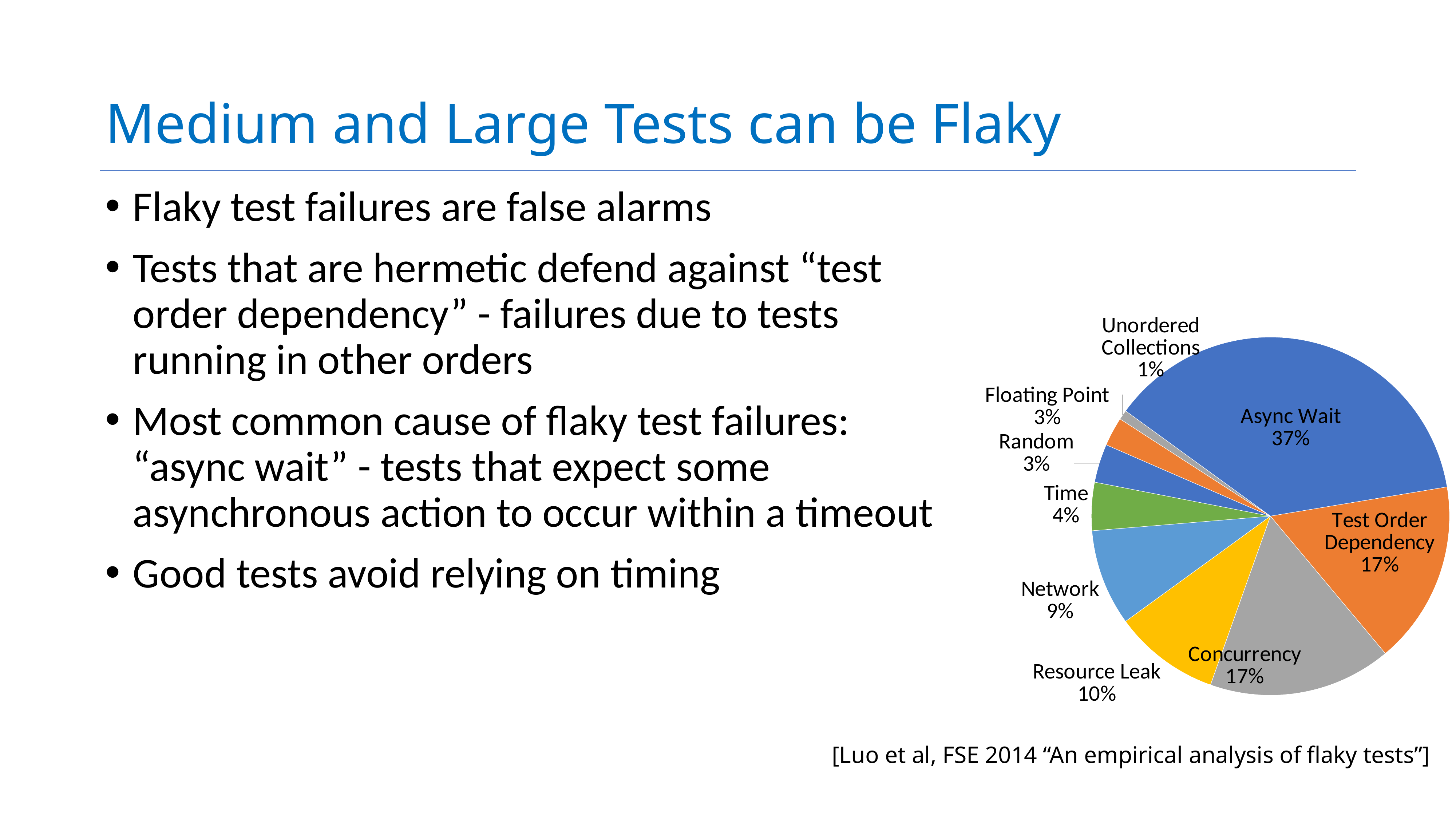
How many categories are shown in the pie chart? 9 What share of the pie does Resource Leak have? 10% What share of the pie does Async Wait have? 37% What is the difference in percentage points between Async Wait and Concurrency? 20 What share of the pie does Network have? 9% Which is larger, the Network slice or the Time slice? Network What kind of chart is shown on the slide? pie chart Which category has the smallest slice of the pie? Unordered Collections Which category has the largest slice of the pie? Async Wait What is the combined share of Resource Leak and Network? 19%